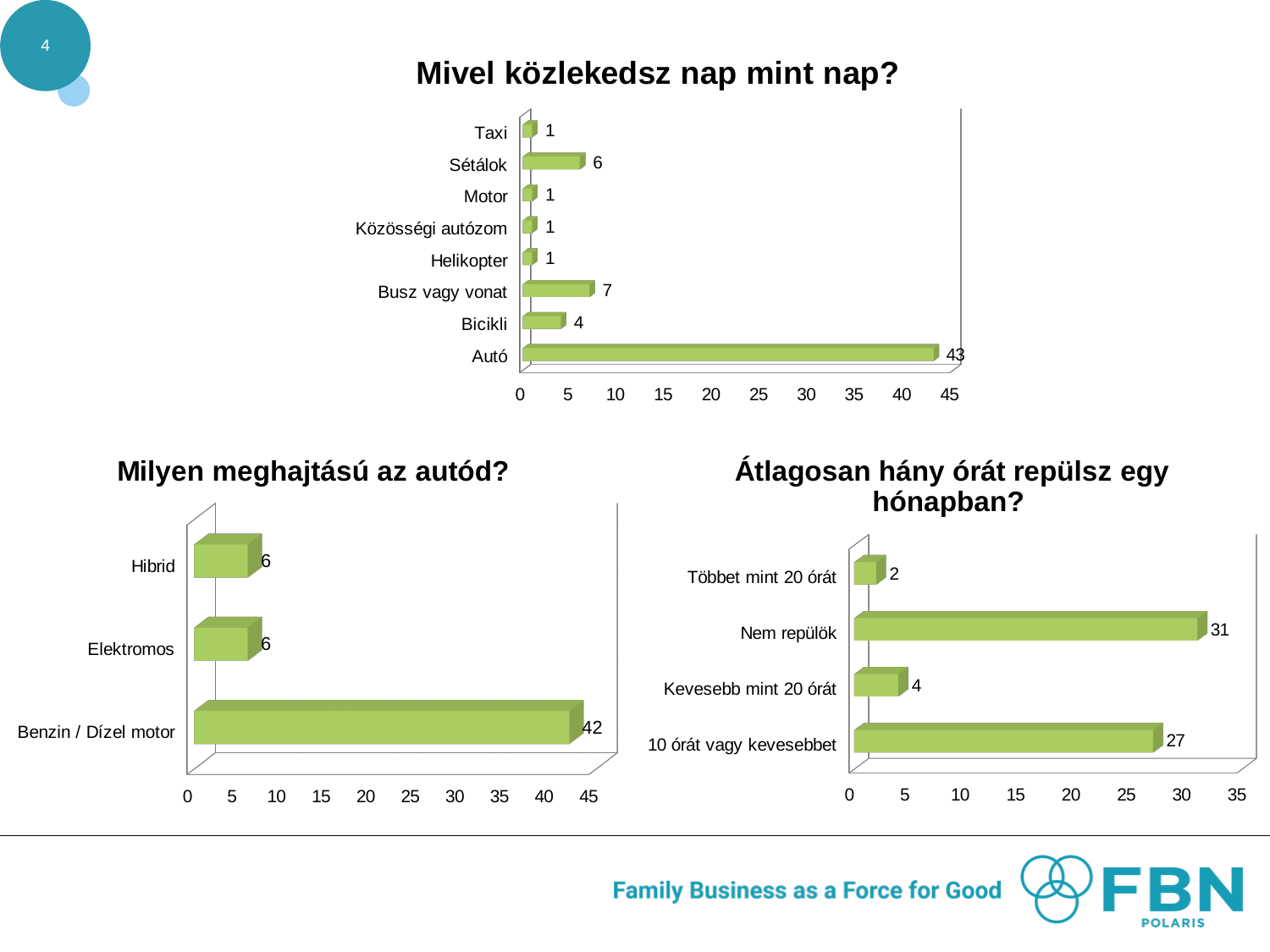
In the chart titled "Mivel közlekedsz nap mint nap?", which is larger, the value for Sétálok or the value for Busz vagy vonat? Busz vagy vonat In the chart titled "Mivel közlekedsz nap mint nap?", what is the difference between the values for Busz vagy vonat and Bicikli? 3 In the chart titled "Mivel közlekedsz nap mint nap?", which category has the highest value? Autó In the chart titled "Átlagosan hány órát repülsz egy hónapban?", what is the value for Nem repülök? 31 In the chart titled "Milyen meghajtású az autód?", how many categories are shown? 3 In the chart titled "Átlagosan hány órát repülsz egy hónapban?", what is the difference between the values for Nem repülök and 10 órát vagy kevesebbet? 4 In the chart titled "Milyen meghajtású az autód?", what is the value for Benzin / Dízel motor? 42 In the chart titled "Milyen meghajtású az autód?", what is the difference between the values for Benzin / Dízel motor and Hibrid? 36 In the chart titled "Átlagosan hány órát repülsz egy hónapban?", which category has the lowest value? Többet mint 20 órát In the chart titled "Mivel közlekedsz nap mint nap?", what is the value for Autó? 43 In the chart titled "Mivel közlekedsz nap mint nap?", how many categories are shown? 8 What kind of chart is the chart titled "Átlagosan hány órát repülsz egy hónapban?"? Bar chart